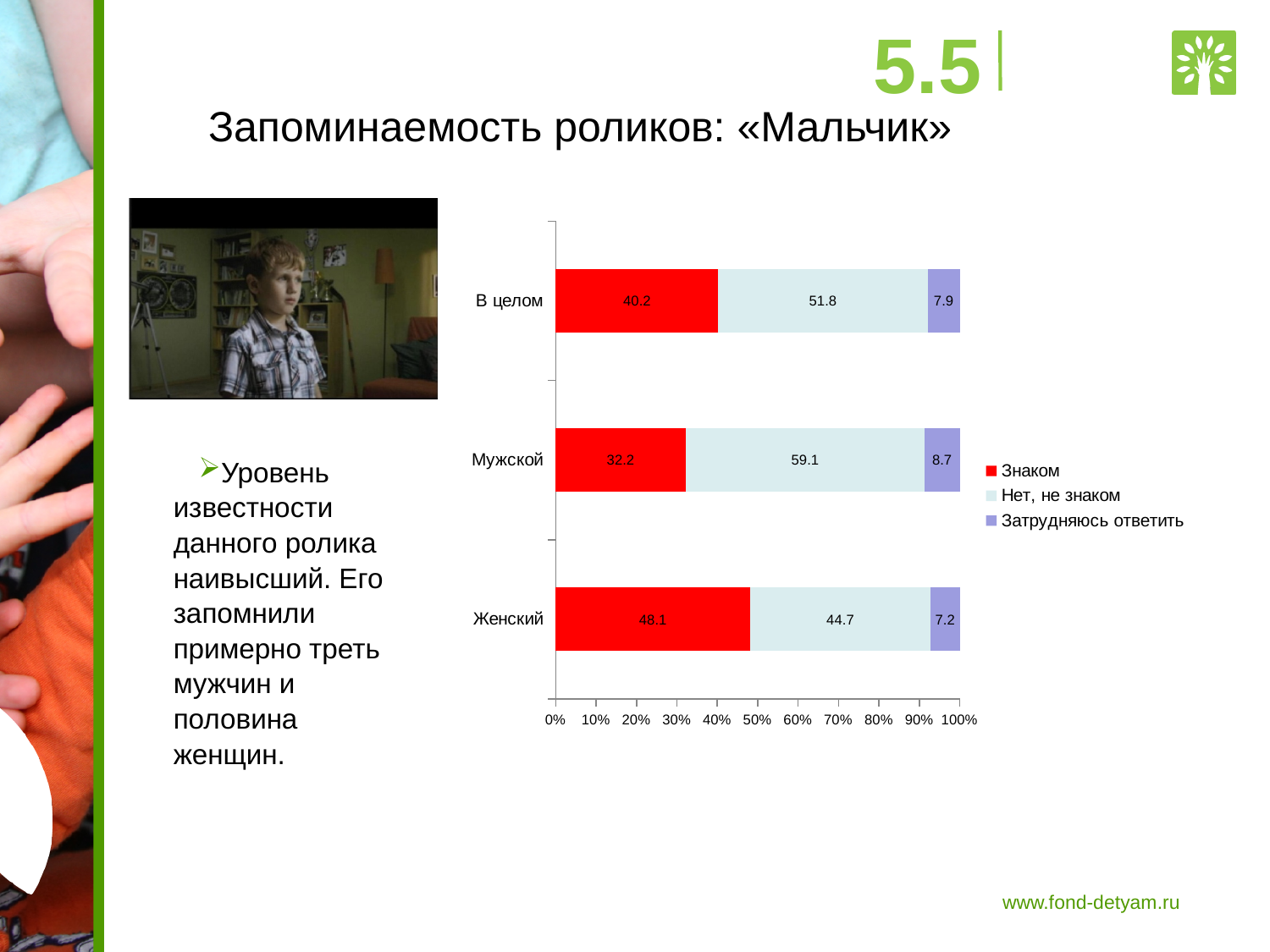
Which category has the highest value for "Знаком"? Женский Which is larger: the "Затрудняюсь ответить" value for "Мужской" or for "В целом"? Мужской Which category has the lowest value for "Нет, не знаком"? Женский Which series is shown in red on the chart? Знаком What is the total of the stacked bar for "Мужской"? 100 What kind of chart is shown on the slide? Stacked bar chart How many categories are shown on the chart? 3 What is the value for "Нет, не знаком" in the "Мужской" category? 59.1 How many series does the legend list? 3 What is the difference between the "Знаком" values for "Женский" and "Мужской"? 15.9 What is the value for "Затрудняюсь ответить" in the "Женский" category? 7.2 What is the value for "Знаком" in the "В целом" category? 40.2